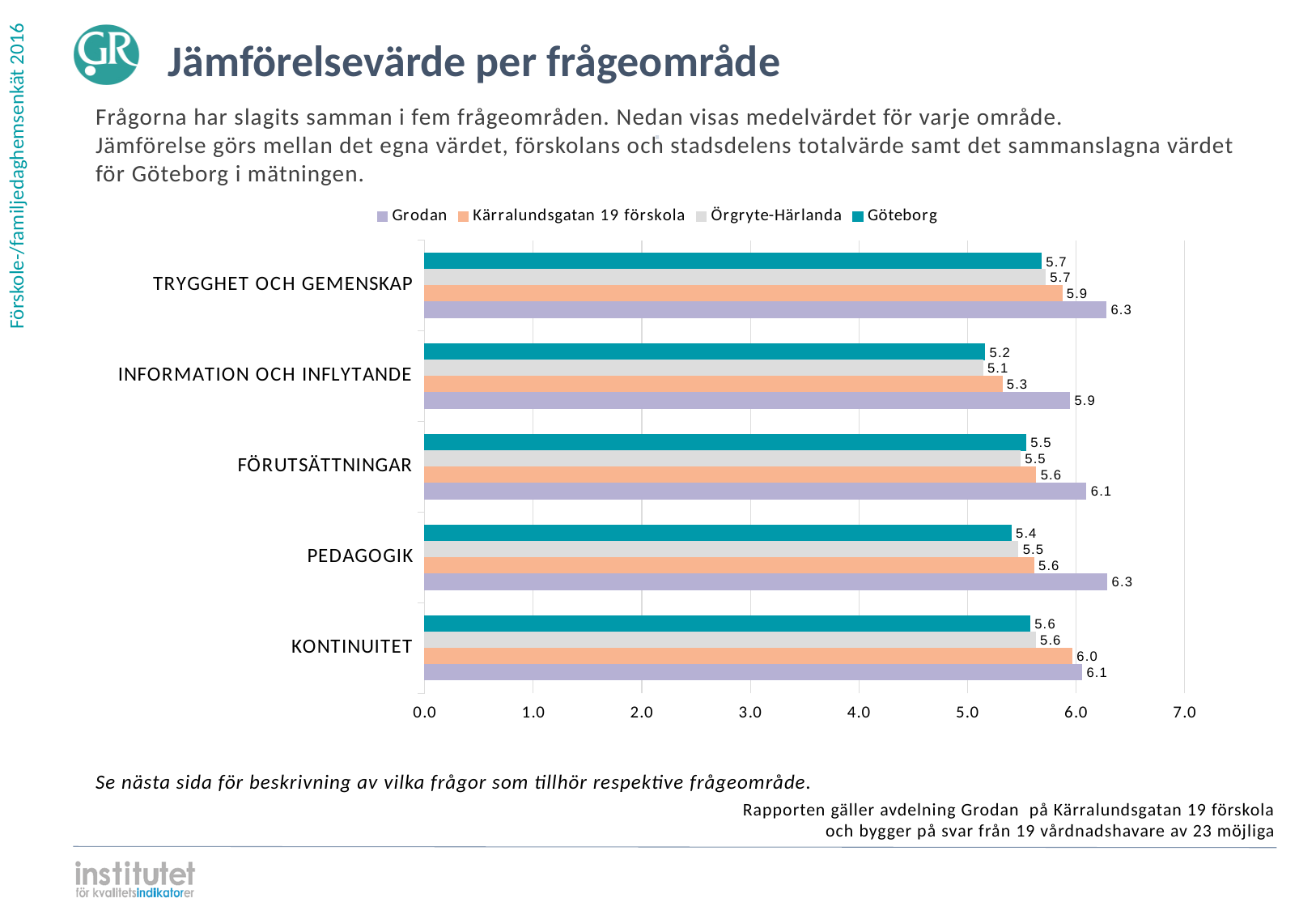
Which category has the highest value for Kärralundsgatan 19 förskola? KONTINUITET What is the difference between the Grodan value and the Göteborg value in PEDAGOGIK? 0.9 What is the value for Grodan in TRYGGHET OCH GEMENSKAP? 6.3 What kind of chart is shown on the slide? Bar chart Which category has the lowest value for Grodan? INFORMATION OCH INFLYTANDE What is the value for Kärralundsgatan 19 förskola in KONTINUITET? 6.0 Which series is shown in teal on the chart? Göteborg What is the value for Örgryte-Härlanda in PEDAGOGIK? 5.5 How many series does the legend list? 4 Which is larger in FÖRUTSÄTTNINGAR: the value for Grodan or the value for Kärralundsgatan 19 förskola? Grodan What is the value for Göteborg in INFORMATION OCH INFLYTANDE? 5.2 How many categories are shown on the chart? 5